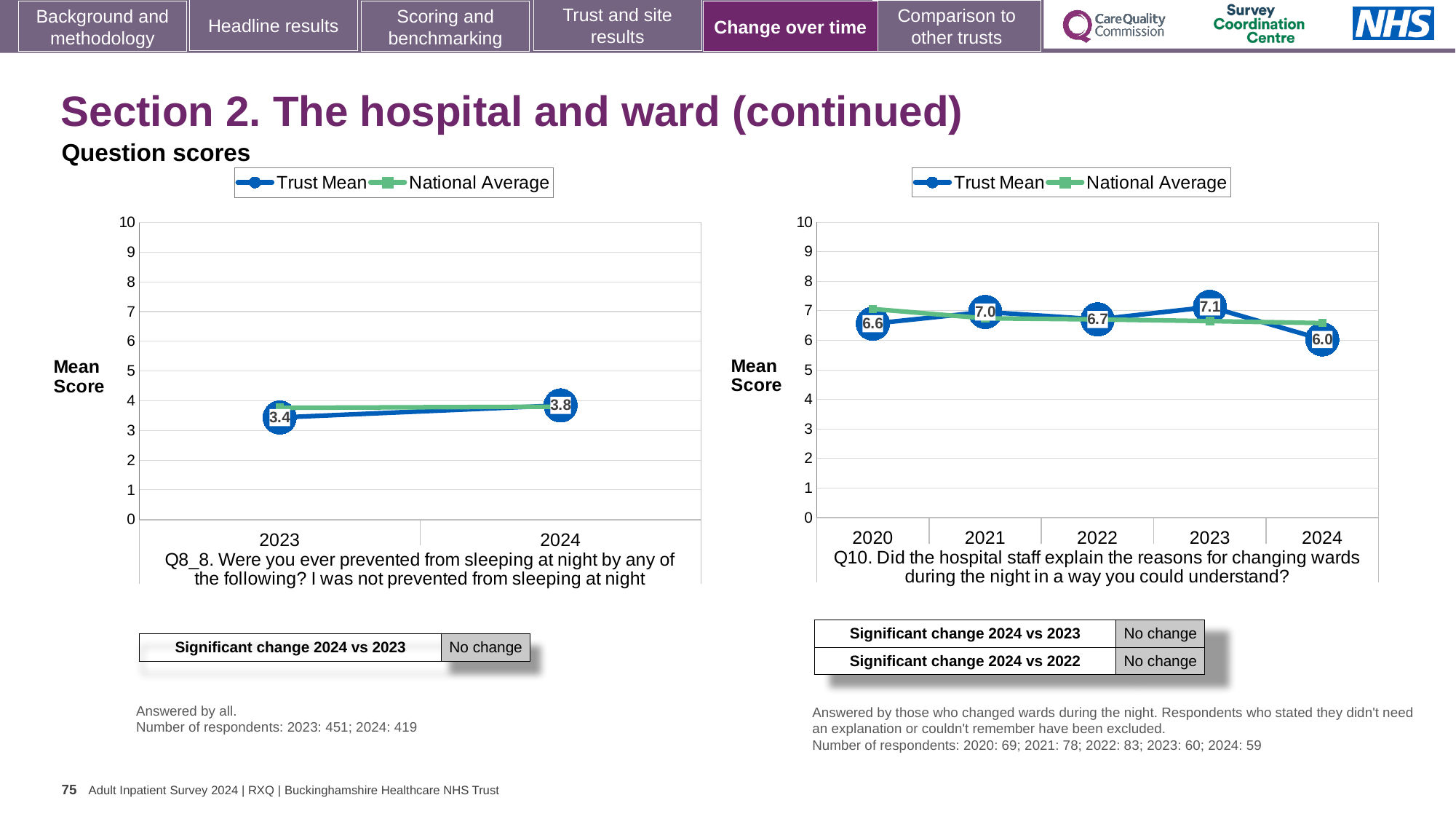
In the left chart (Q8_8), does the Trust Mean rise or fall from 2023 to 2024? rise In the right chart (Q10), what is the Trust Mean score for 2021? 7.0 In the left chart (Q8_8), by how much did the Trust Mean change from 2023 to 2024? 0.4 In the right chart (Q10), what is the Trust Mean score for 2024? 6.0 In the right chart (Q10), is the Trust Mean for 2020 or 2022 higher? 2022 How many years are plotted on the x axis of the right chart (Q10)? 5 In the left chart (Q8_8), what is the Trust Mean score for 2023? 3.4 In the right chart (Q10), what is the difference between the Trust Mean scores for 2023 and 2024? 1.1 In the right chart (Q10), which year has the highest Trust Mean score? 2023 How many series does the legend of the left chart (Q8_8) list? 2 In the left chart (Q8_8), what is the Trust Mean score for 2024? 3.8 In the right chart (Q10), which year has the lowest Trust Mean score? 2024